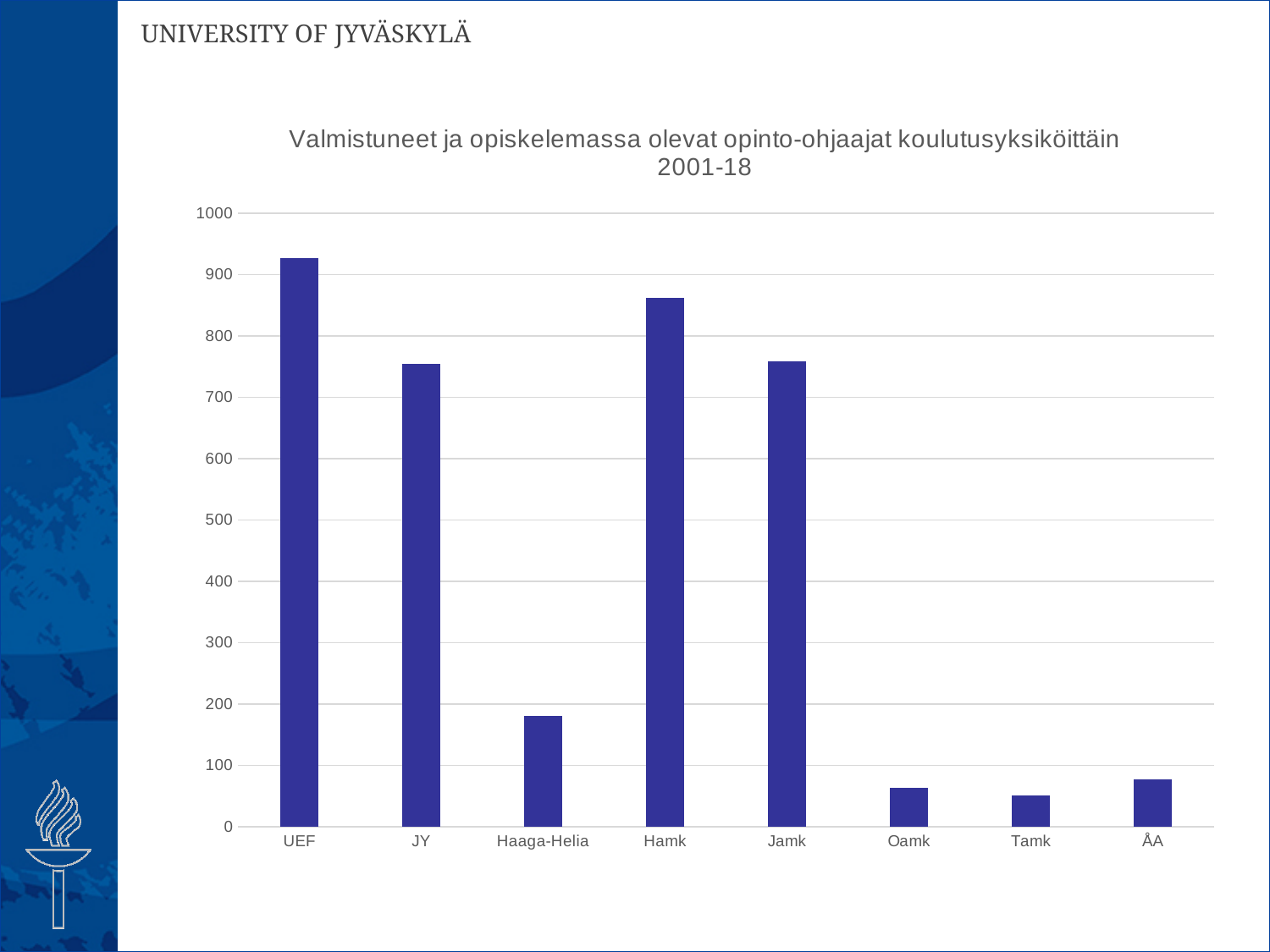
Which is larger, the value for Haaga-Helia or the value for Oamk? Haaga-Helia Is the value for UEF greater or less than 900? greater Is the value for Tamk greater or less than 100? less What is the maximum value shown on the y axis? 1000 What kind of chart is shown on the slide? bar chart Which education unit has the highest bar? UEF What is the title of the chart? Valmistuneet ja opiskelemassa olevat opinto-ohjaajat koulutusyksiköittäin 2001-18 Is the value for JY greater or less than 700? greater Which is larger, the value for Hamk or the value for Jamk? Hamk How many categories (education units) are shown on the x axis? 8